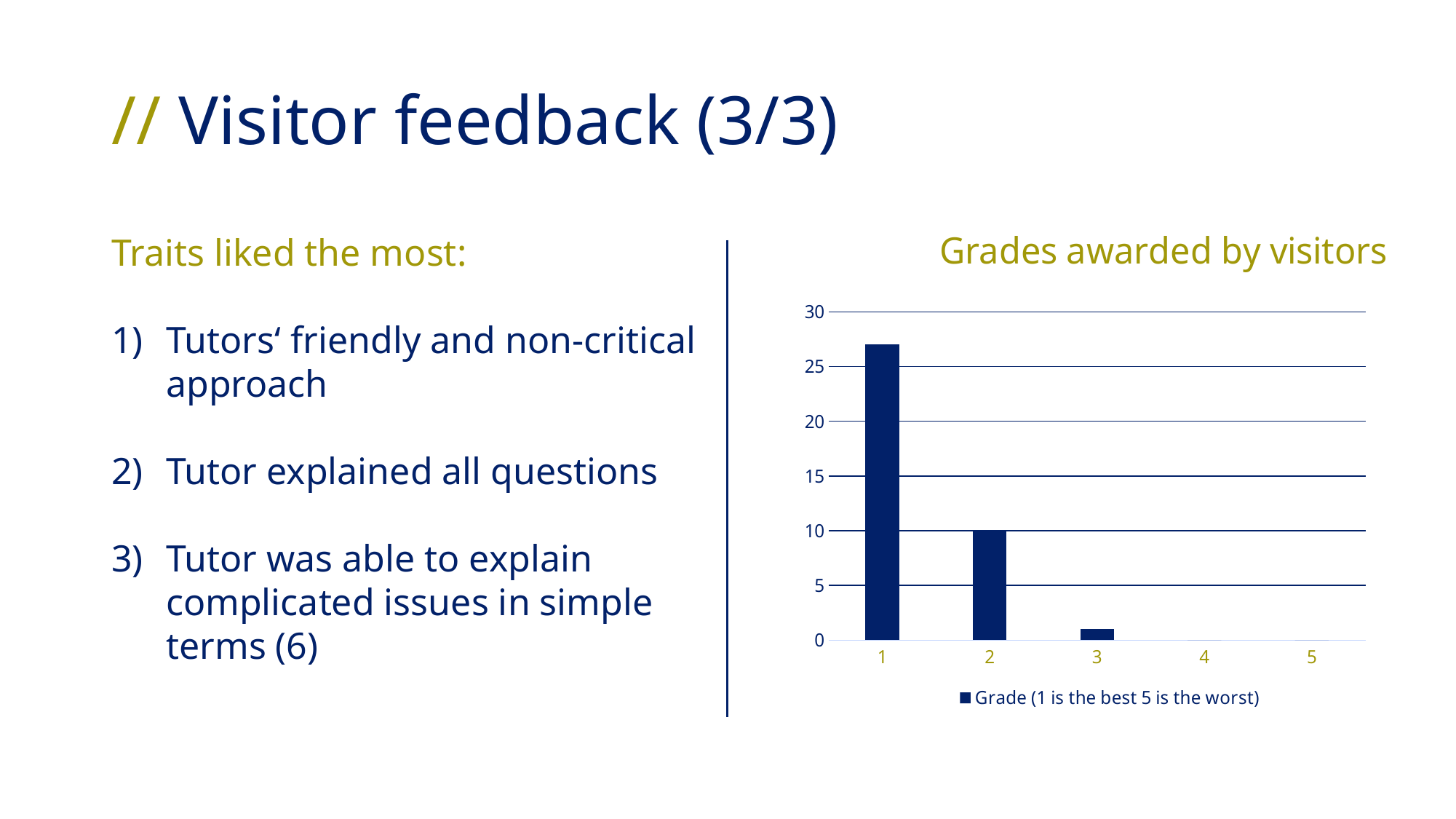
How many grade categories are shown on the x axis of the chart? 5 What kind of chart is shown on the slide? bar chart Which has a larger value in the chart, grade 1 or grade 2? grade 1 Is the value for grade 1 greater or less than 25? greater Which grade received the highest number of votes in the chart? 1 What is the title of the chart? Grades awarded by visitors How many visitors awarded grade 2 according to the chart? 10 What is the legend entry of the chart? Grade (1 is the best 5 is the worst) How many series does the chart legend list? 1 Is the value for grade 1 greater or less than 30? less Do the values rise or fall as the grade goes from 1 to 5 along the x axis? fall Is the value for grade 3 greater or less than 5? less